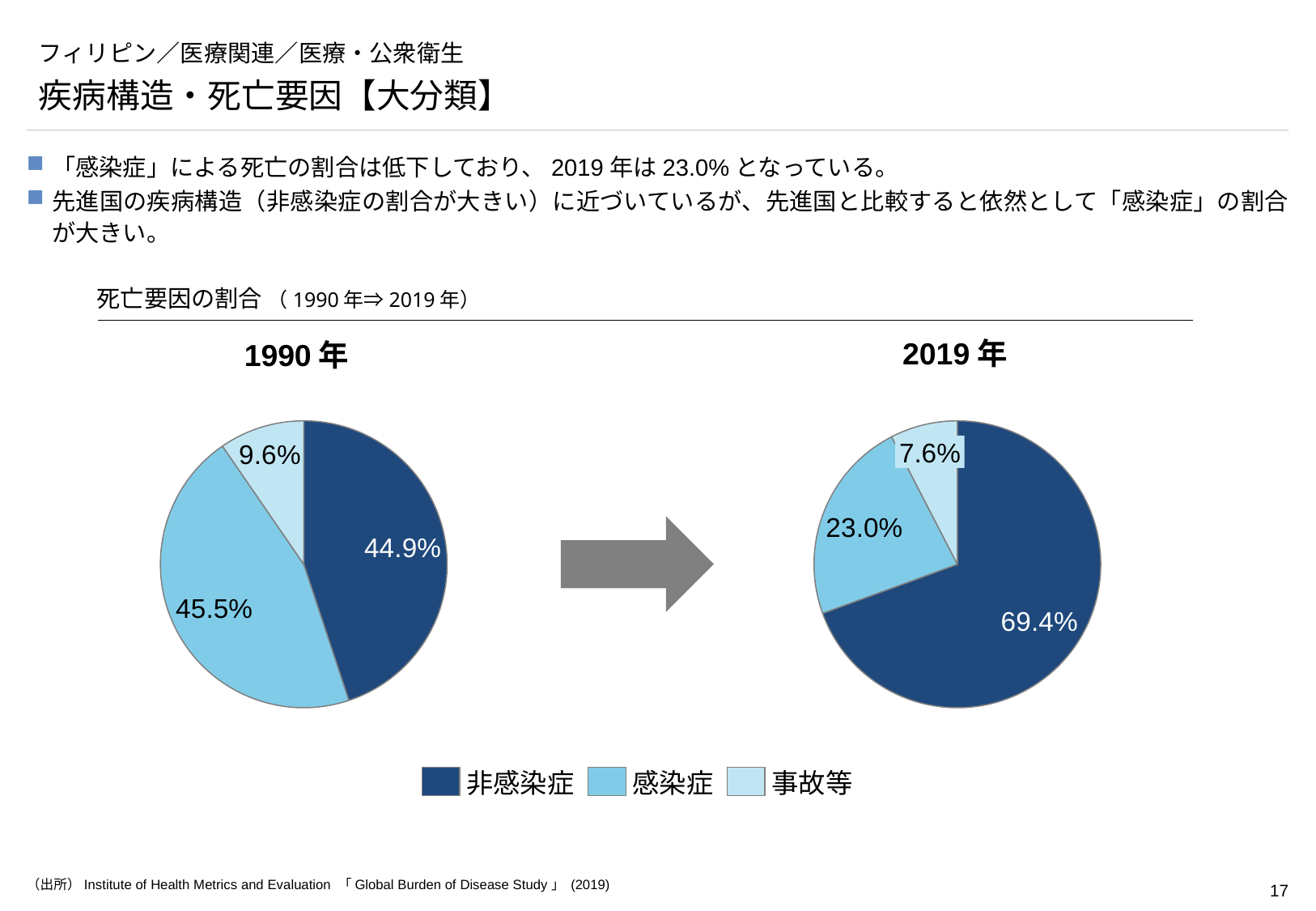
In the 1990年 pie chart, what share is shown for 非感染症? 44.9% In the 2019年 pie chart, what share is shown for 感染症? 23.0% In the 1990年 pie chart, which category has the smallest share? 事故等 In the 1990年 pie chart, what share is shown for 事故等? 9.6% In the 2019年 pie chart, what share is shown for 非感染症? 69.4% How many categories does the legend list for the pie charts? 3 In the 2019年 pie chart, which category has the largest share? 非感染症 In the 2019年 pie chart, what is the difference between the shares of 非感染症 and 感染症? 46.4% What type of chart is used to show 死亡要因の割合 for 1990年 and 2019年? Pie chart In the 1990年 pie chart, what share is shown for 感染症? 45.5% In the 2019年 pie chart, what share is shown for 事故等? 7.6% Is the share of 感染症 larger in the 1990年 pie chart or the 2019年 pie chart? 1990年